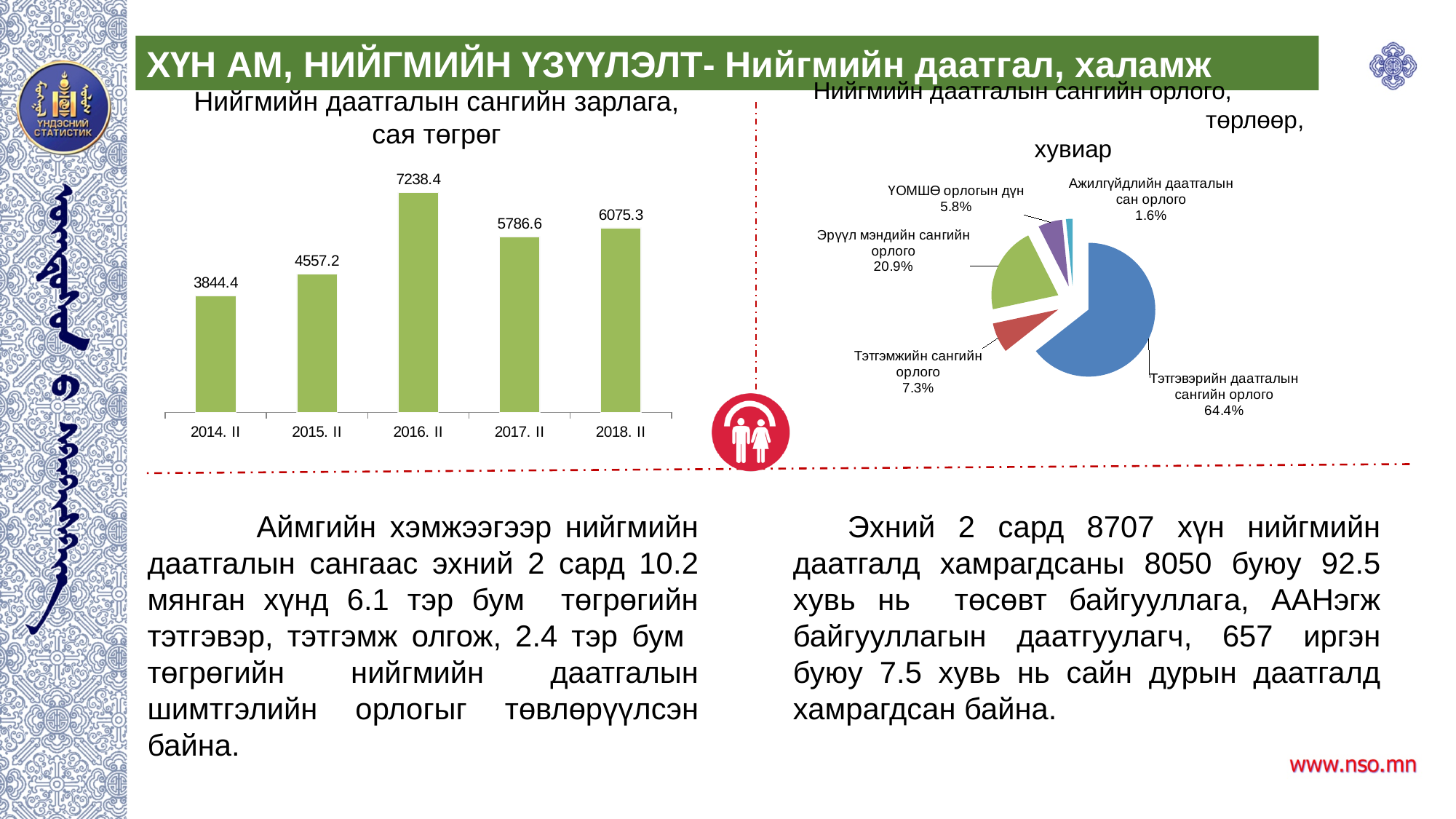
In the bar chart on the left, which period has the highest value? 2016. II How many periods are shown in the bar chart on the left? 5 How many slices does the pie chart on the right have? 5 In the pie chart on the right, which category has the smallest share? Ажилгүйдлийн даатгалын сан орлого In the bar chart on the left, which period has the lowest value? 2014. II In the pie chart on the right, what share does Тэтгэврийн даатгалын сангийн орлого have? 64.4% In the bar chart on the left, what is the difference between the values for 2018. II and 2017. II? 288.7 In the bar chart on the left, which is larger: the value for 2015. II or 2017. II? 2017. II In the pie chart on the right, what share does Эрүүл мэндийн сангийн орлого have? 20.9% In the bar chart on the left, what is the value for 2016. II? 7238.4 What kind of chart is the chart on the left of the slide? Bar chart In the bar chart on the left, what is the value for 2014. II? 3844.4